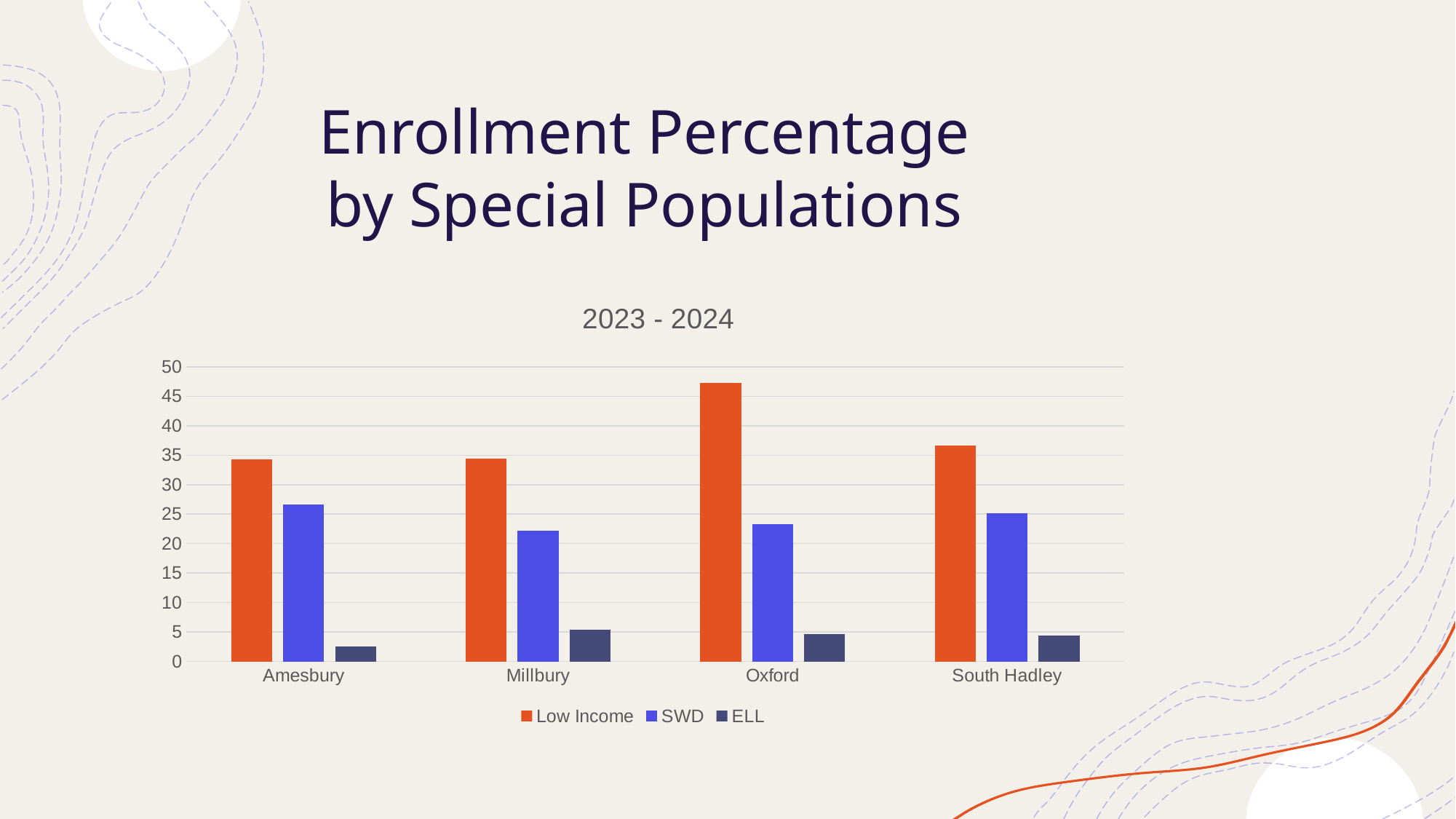
What school year is shown in the chart's subtitle? 2023 - 2024 How many series does the legend list? 3 Is the SWD value for Millbury greater or less than 25? less Is the SWD value for Amesbury greater or less than 25? greater Which district has the highest Low Income enrollment percentage? Oxford Is the Low Income value for South Hadley greater or less than 35? greater How many districts are shown on the x axis? 4 Which district has the lowest ELL enrollment percentage? Amesbury What kind of chart is shown on the slide? bar chart Which is larger for Oxford, the Low Income value or the SWD value? Low Income